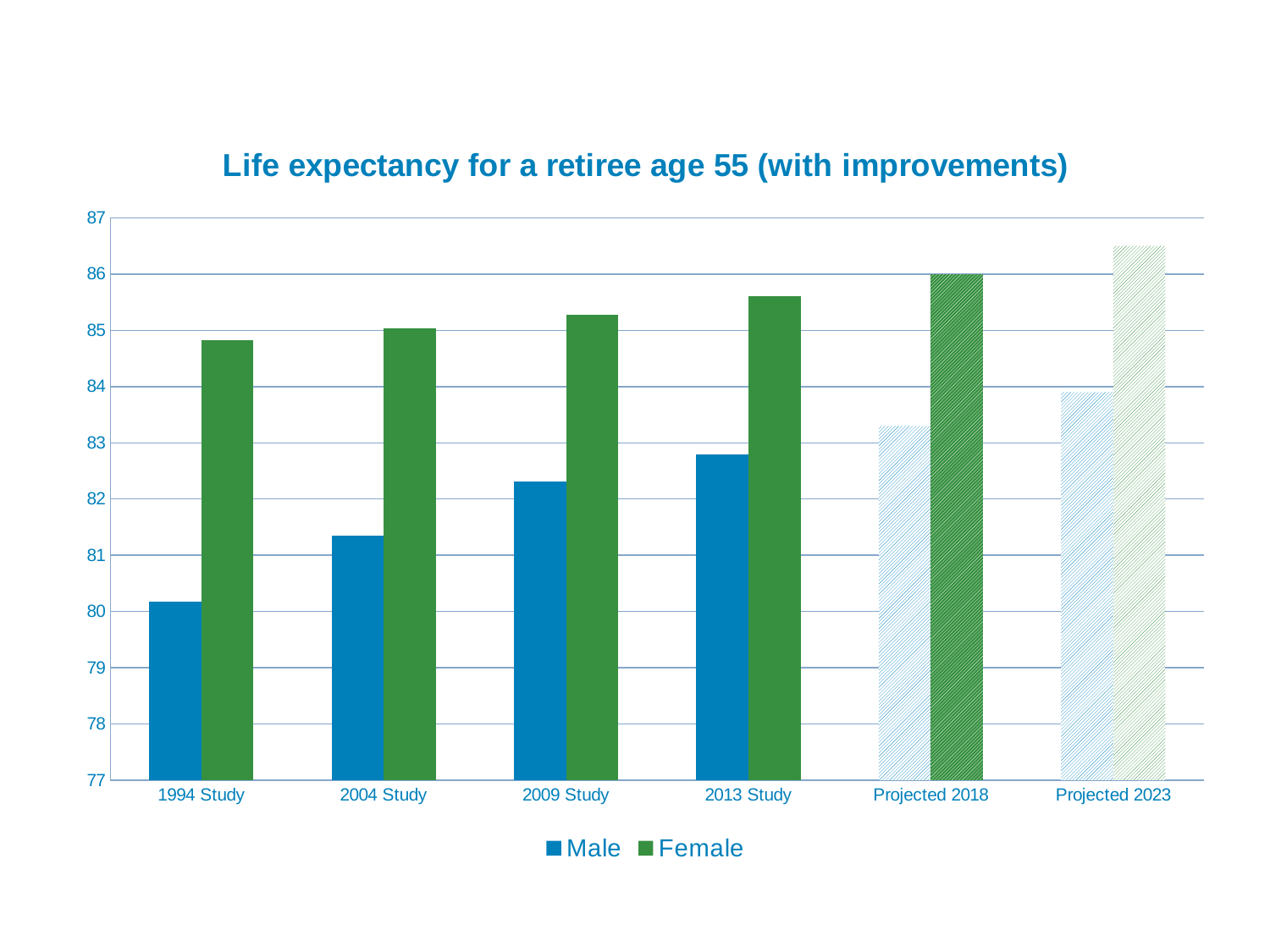
Is the Female value for the 1994 Study greater or less than 85? less What is the title of the chart? Life expectancy for a retiree age 55 (with improvements) Do the Male values rise or fall from the 1994 Study to Projected 2023? rise Is the Male value for Projected 2018 greater or less than 83? greater Is the Male value for the 1994 Study greater or less than 81? less What kind of chart is shown on the slide? Bar chart How many categories are shown on the x axis? 6 Which category has the highest Female value? Projected 2023 Which category has the lowest Male value? 1994 Study How many series does the legend list? 2 Which is larger, the Female value for the 2013 Study or the Male value for Projected 2023? Female value for the 2013 Study